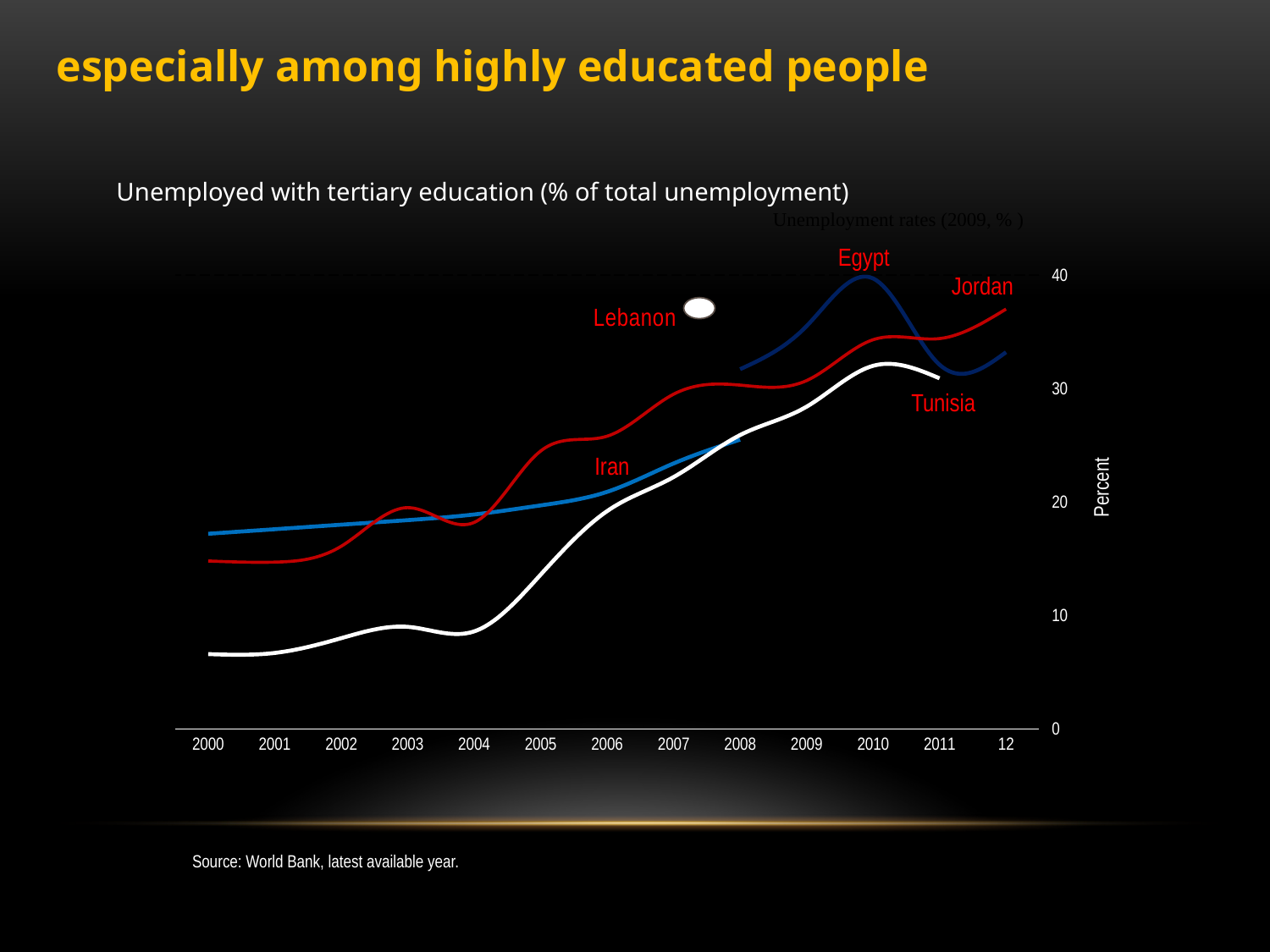
Is the value for Jordan in 2012 greater or less than 30? greater In 2000, which is higher: Jordan or Tunisia? Jordan What kind of chart is shown on the slide? line chart Does the Tunisia line rise or fall between 2000 and 2010? rise Which country has the highest value in 2010? Egypt Is the value for Jordan in 2000 greater or less than 20? less Is the value for Tunisia in 2008 greater or less than 20? greater What is the label on the vertical axis of the chart? Percent Does the Jordan line rise or fall overall between 2000 and 2012? rise How many years are labelled along the x axis of the chart? 13